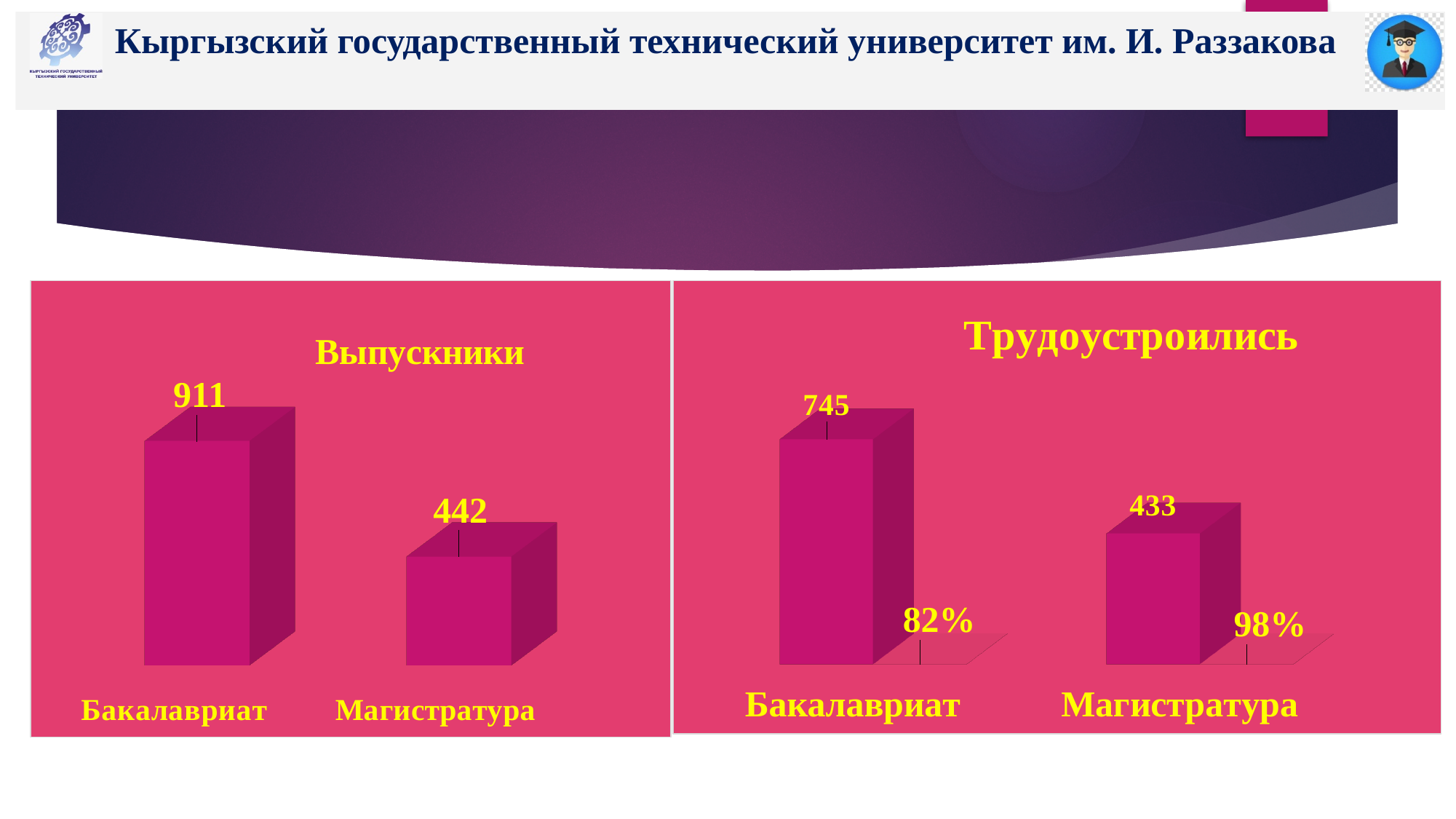
How many categories does the 'Выпускники' chart show? 2 In the 'Трудоустроились' chart, what is the value for Бакалавриат? 745 In the 'Трудоустроились' chart, what percentage is shown for Бакалавриат? 82% In the 'Выпускники' chart, what is the value for Бакалавриат? 911 In the 'Трудоустроились' chart, what is the value for Магистратура? 433 In the 'Трудоустроились' chart, what is the difference between the values for Бакалавриат and Магистратура? 312 In the 'Выпускники' chart, which category has the highest value? Бакалавриат What kind of chart is the 'Трудоустроились' chart? Bar chart In the 'Трудоустроились' chart, which category has the lowest value? Магистратура In the 'Трудоустроились' chart, what percentage is shown for Магистратура? 98% In the 'Выпускники' chart, what is the value for Магистратура? 442 In the 'Выпускники' chart, what is the difference between the values for Бакалавриат and Магистратура? 469